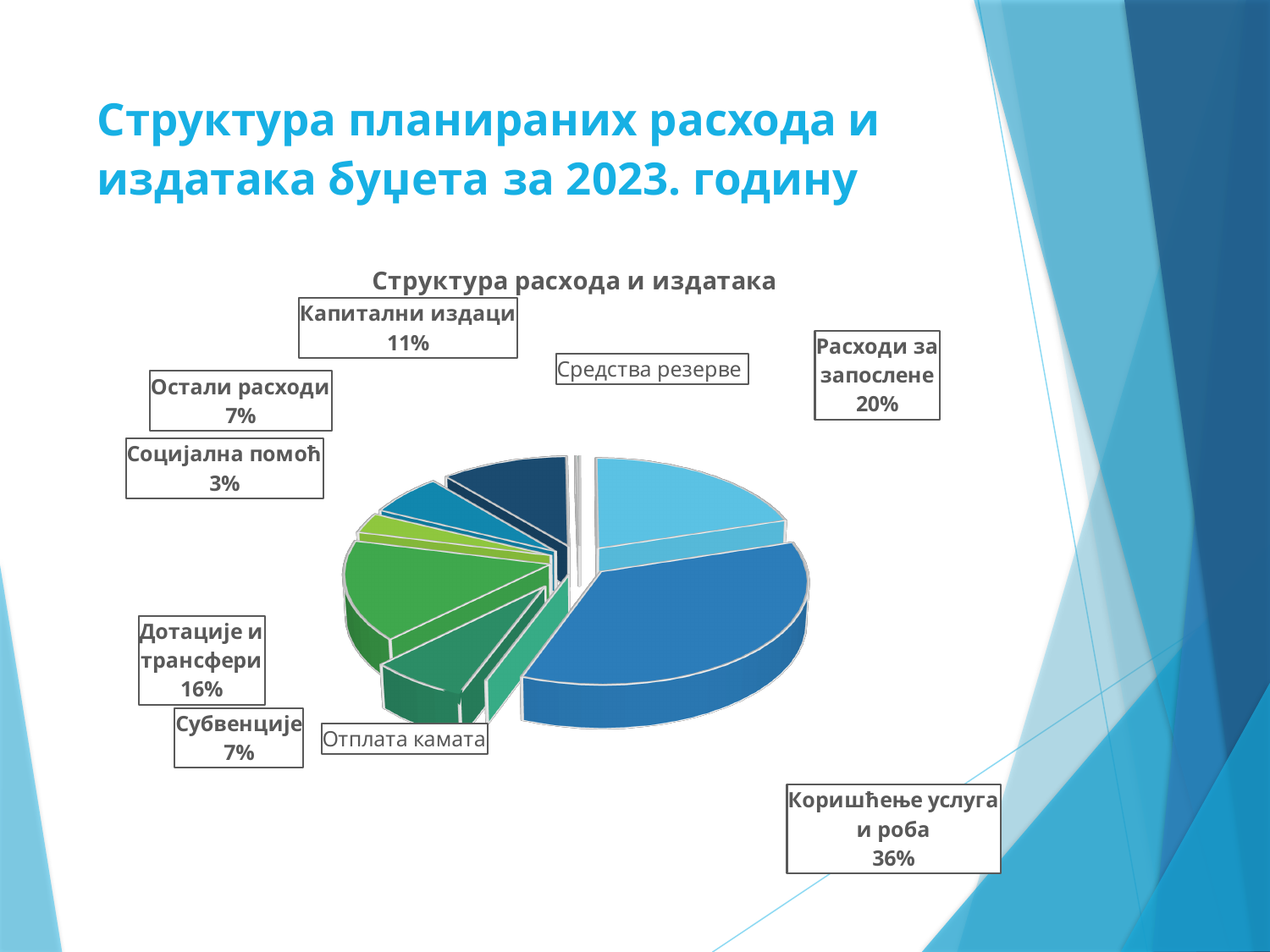
Which is larger, the share for Дотације и трансфери or the share for Капитални издаци? Дотације и трансфери What type of chart is shown on the slide? pie chart What percentage is shown for Субвенције? 7% What percentage is shown for Социјална помоћ? 3% What is the title of the chart? Структура расхода и издатака What is the difference in percentage points between Коришћење услуга и роба and Расходи за запослене? 16 What percentage is shown for Расходи за запослене? 20% How many categories are shown in the pie chart? 9 What percentage is shown for Дотације и трансфери? 16% What share of the pie is Коришћење услуга и роба? 36% What percentage is shown for Капитални издаци? 11% Which category has the largest share of the pie? Коришћење услуга и роба